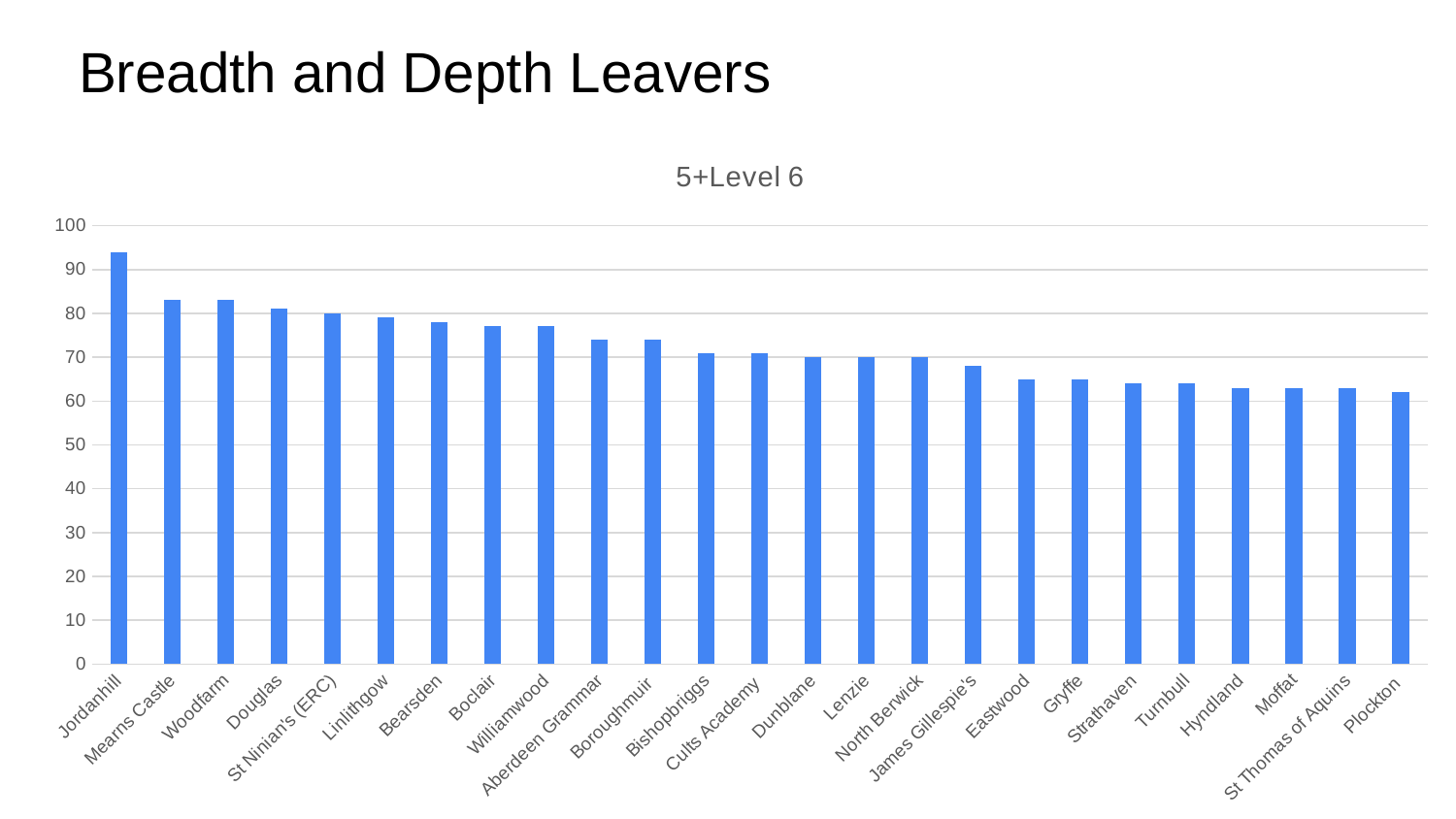
What type of chart is shown on the slide? bar chart Which school has the highest value in the chart? Jordanhill Is the value for Plockton greater or less than 60? greater Do the values rise or fall moving from left to right along the x axis? fall Which has the larger value, Jordanhill or Plockton? Jordanhill Which has the larger value, Mearns Castle or Eastwood? Mearns Castle What is the title of the chart? 5+Level 6 Is the value for Boroughmuir greater or less than 80? less Is the value for Jordanhill greater or less than 90? greater How many schools are shown on the x axis of the chart? 25